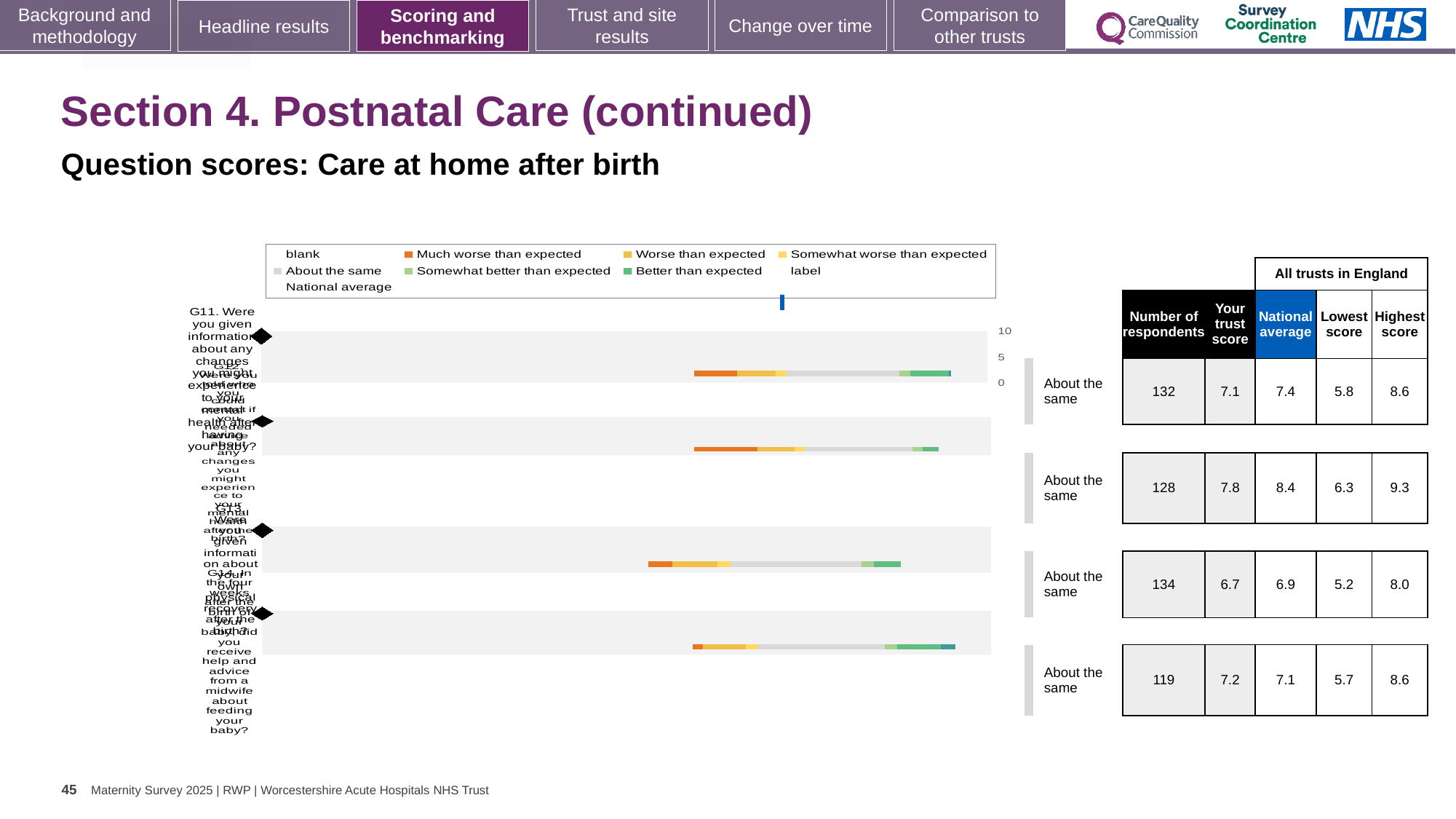
In the chart legend, which category is shown in dark orange? Much worse than expected In the table beside the chart, what is the highest value in the 'Highest score' column? 9.3 How many bars (question rows) are plotted in the chart? 4 In the table beside the chart, which row has the highest 'Your trust score'? the second row (7.8) In the table beside the chart, what is the difference between the national average and your trust score in the second row? 0.6 In the table beside the chart, for the first row, which is larger: your trust score or the national average? National average In the table beside the chart, what is the lowest value in the 'Lowest score' column? 5.2 What benchmark label is shown for each of the four rows next to the chart? About the same In the table beside the chart, what is the number of respondents for the fourth row? 119 What kind of chart is shown on the slide? bar chart In the table beside the chart, what is the number of respondents for the first row? 132